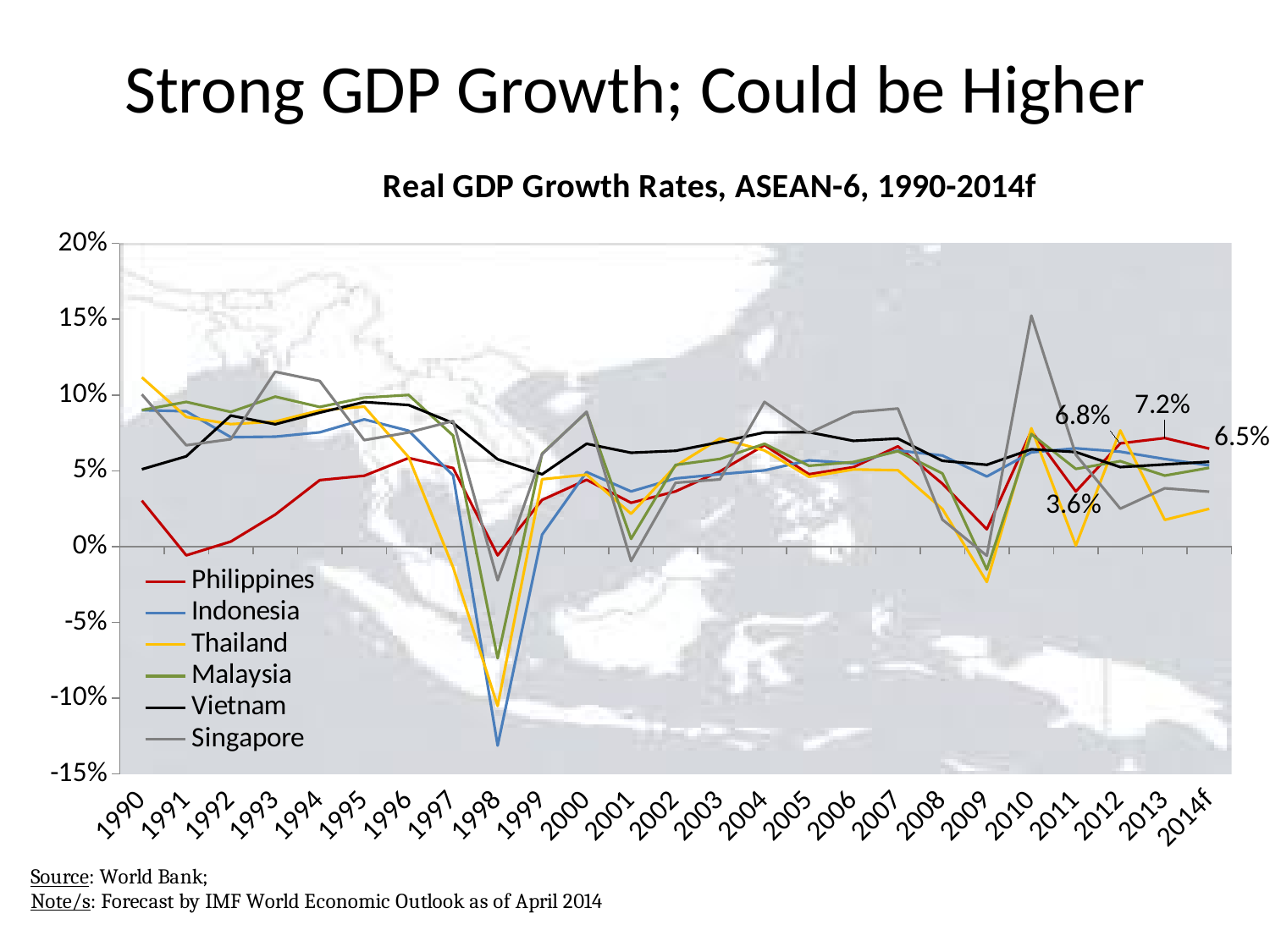
What is the labelled real GDP growth rate for the Philippines in 2013? 7.2% How many years are shown along the x axis? 25 What is the labelled real GDP growth rate for the Philippines in 2011? 3.6% Which country has the lowest growth rate in 1998? Indonesia What kind of chart is shown on the slide? line chart Is the value for Indonesia in 1998 greater or less than -10%? less What is the labelled real GDP growth rate for the Philippines in 2014f? 6.5% Is the value for Singapore in 2010 greater or less than 10%? greater What is the difference between the Philippines' labelled growth rates in 2013 and 2011? 3.6% How many series does the legend list? 6 Which is larger for the Philippines: the labelled growth rate in 2012 or in 2014f? 2012 What is the labelled real GDP growth rate for the Philippines in 2012? 6.8%